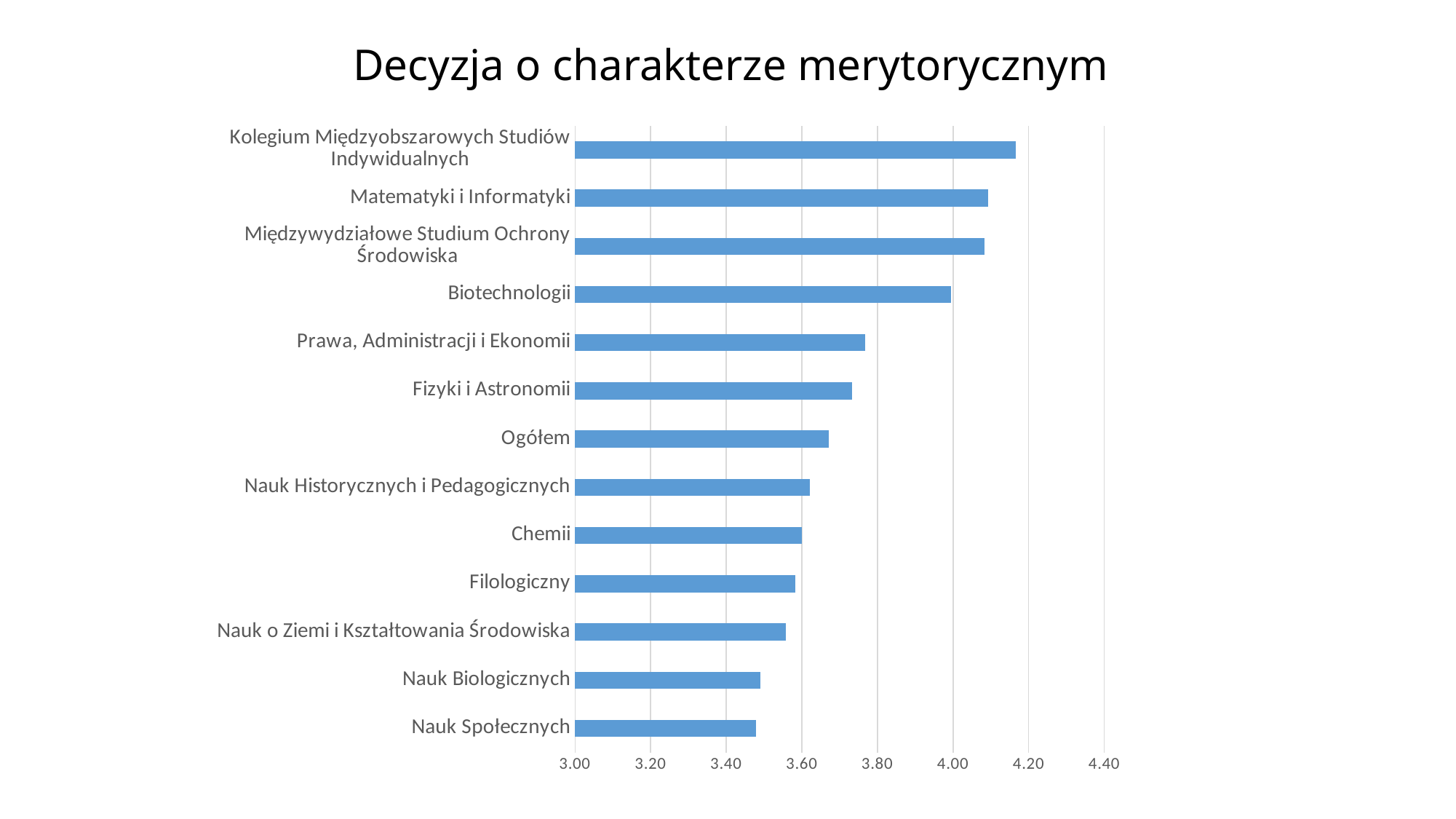
Is the value for Prawa, Administracji i Ekonomii greater or less than 3.80? less Is the value for Nauk Biologicznych greater or less than 3.60? less Which has a larger value, Biotechnologii or Prawa, Administracji i Ekonomii? Biotechnologii Is the value for Nauk Społecznych greater or less than 3.60? less Which category has the highest value? Kolegium Międzyobszarowych Studiów Indywidualnych Which has a larger value, Fizyki i Astronomii or Nauk Biologicznych? Fizyki i Astronomii How many categories are plotted in the chart? 13 What type of chart is shown on the slide? bar chart What is the title of the chart? Decyzja o charakterze merytorycznym